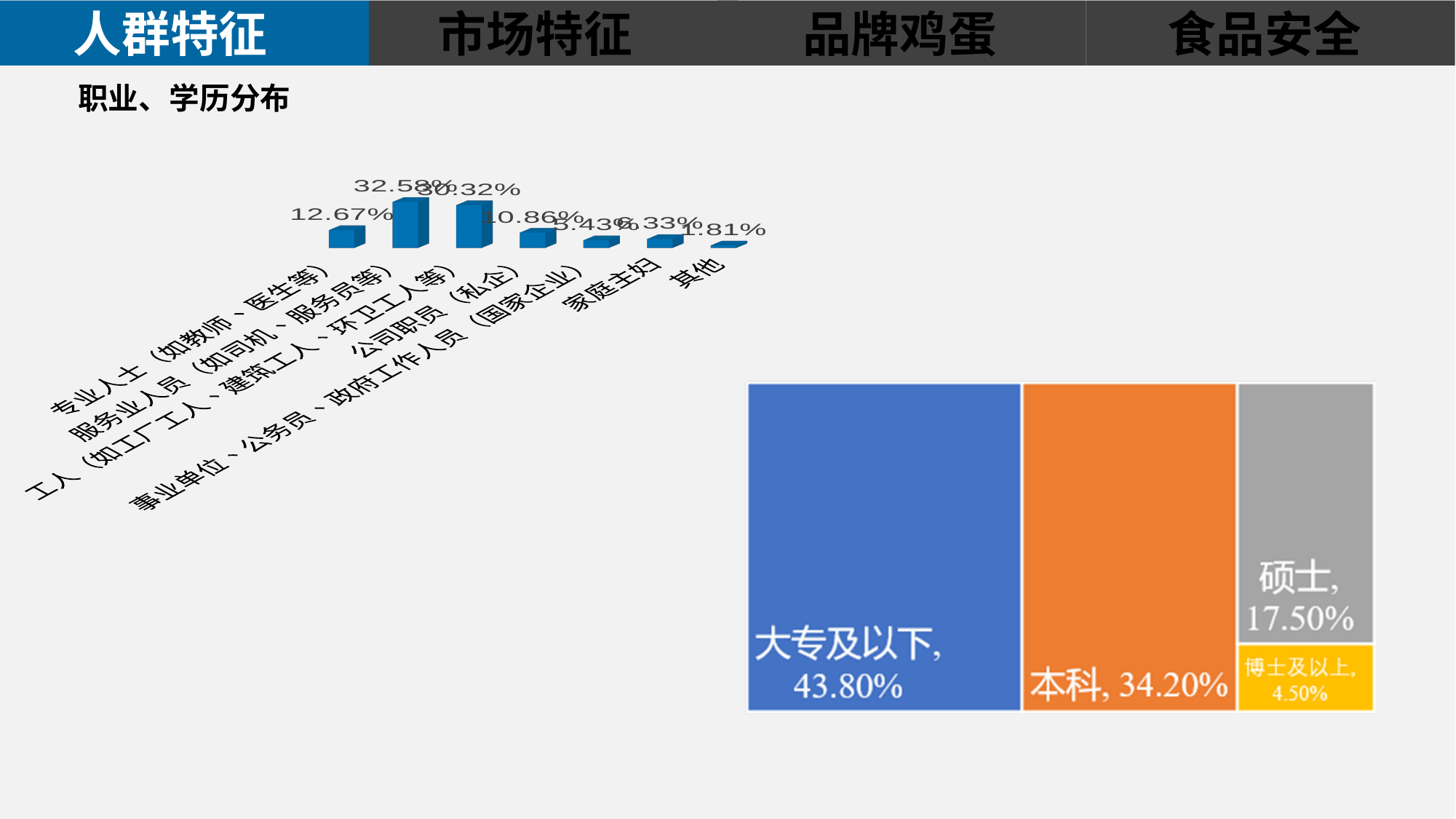
In the bar chart on the left, which is larger: 专业人士（如教师、医生等） or 公司职员（私企）? 专业人士（如教师、医生等） In the bar chart on the left, which category has the lowest value? 其他 In the treemap on the right, what is the value for 博士及以上? 4.50% In the treemap on the right, which education level has the largest share? 大专及以下 In the treemap on the right, what is the difference between 大专及以下 and 硕士? 26.30% In the bar chart on the left, what is the difference between 专业人士（如教师、医生等） and 其他? 10.86% In the bar chart on the left, what is the value for 公司职员（私企）? 10.86% In the bar chart on the left, how many occupation categories are shown? 7 In the bar chart on the left, what is the value for 其他? 1.81% In the treemap on the right, what is the value for 本科? 34.20% In the bar chart on the left, what is the value for 专业人士（如教师、医生等）? 12.67% In the bar chart on the left, which category has the highest value? 服务业人员（如司机、服务员等）